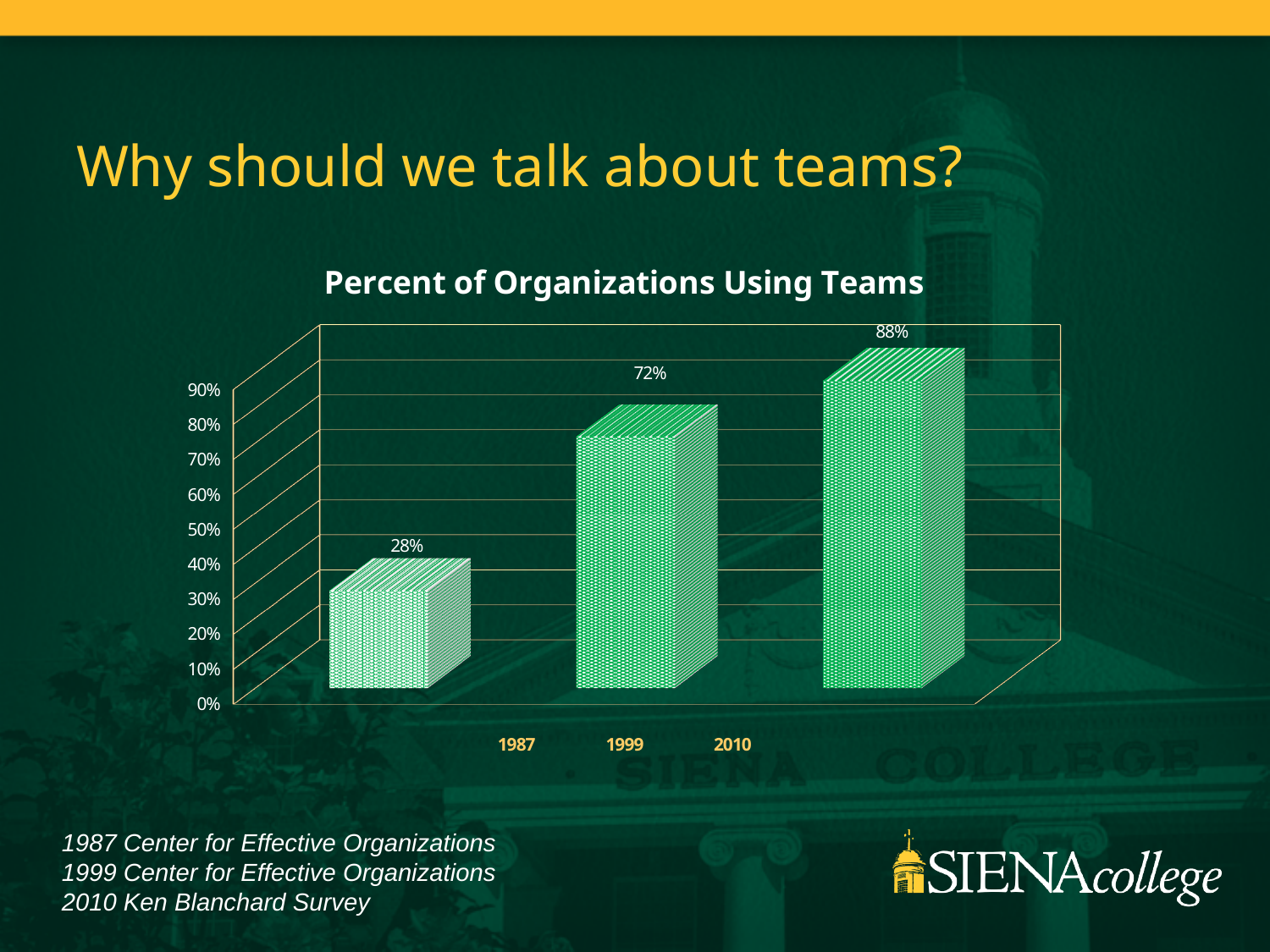
What is the value for 1999? 72% How many years are shown on the chart? 3 What kind of chart is this? Bar chart What is the difference between the values for 1999 and 1987? 44% Do the values rise or fall from 1987 to 2010? Rise What is the title of the chart? Percent of Organizations Using Teams What is the value for 2010? 88% Which year has the lowest percent of organizations using teams? 1987 What is the difference between the values for 2010 and 1987? 60% Which year has the highest percent of organizations using teams? 2010 What is the value for 1987? 28% Which is larger, the value for 1999 or the value for 2010? 2010